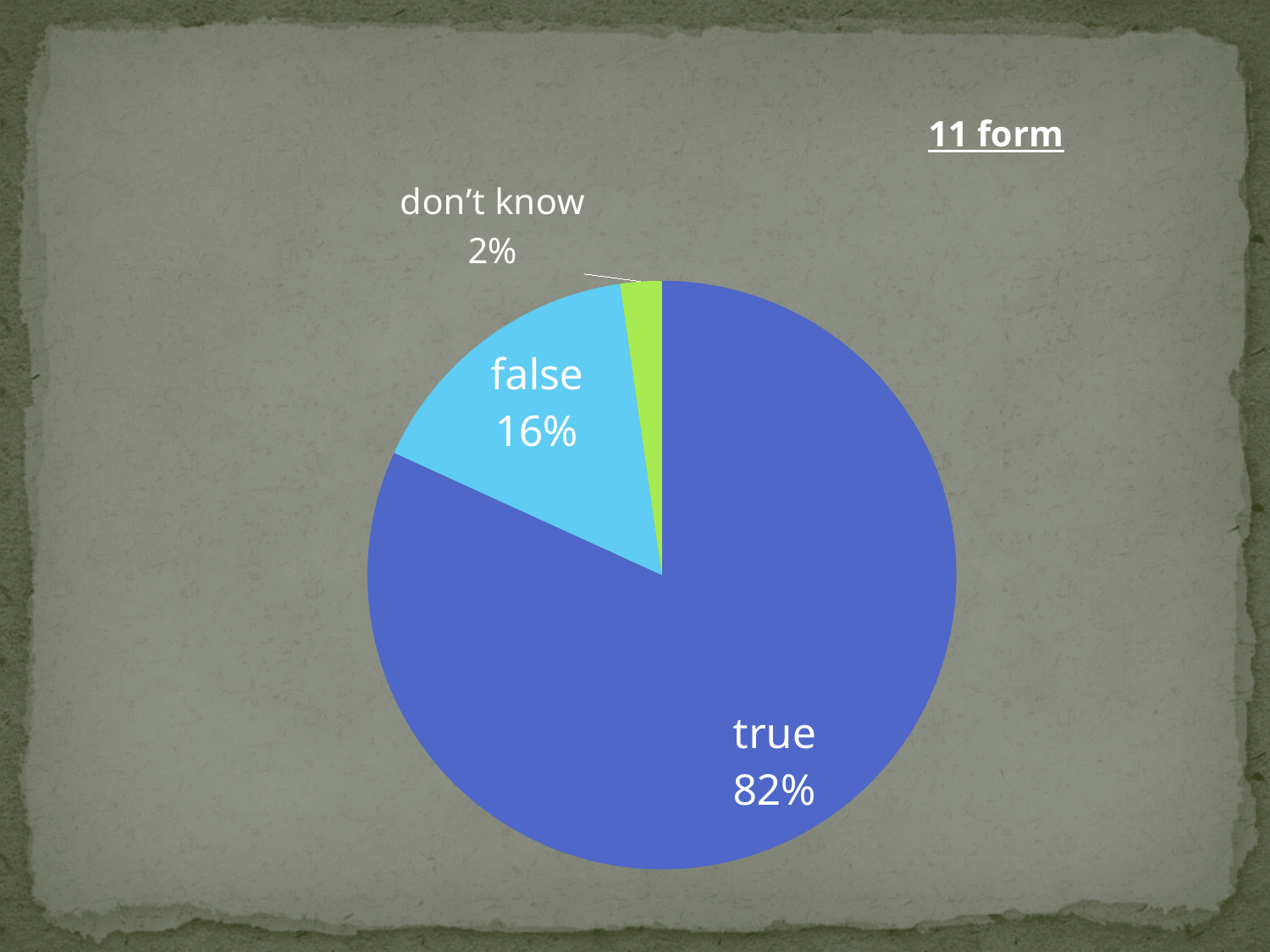
What is the difference in percentage points between the "false" and "don't know" slices? 14 What is the difference in percentage points between the "true" and "false" slices? 66 What share of the pie is labelled "true"? 82% Which slice of the pie is the smallest? don't know What colour is the "true" slice of the pie? blue What text appears in the top-right corner of the slide above the chart? 11 form Which is larger, the "false" slice or the "don't know" slice? false What share of the pie is labelled "don't know"? 2% How many slices does the pie chart have? 3 Which slice of the pie is the largest? true What kind of chart is shown on the slide? pie chart What share of the pie is labelled "false"? 16%